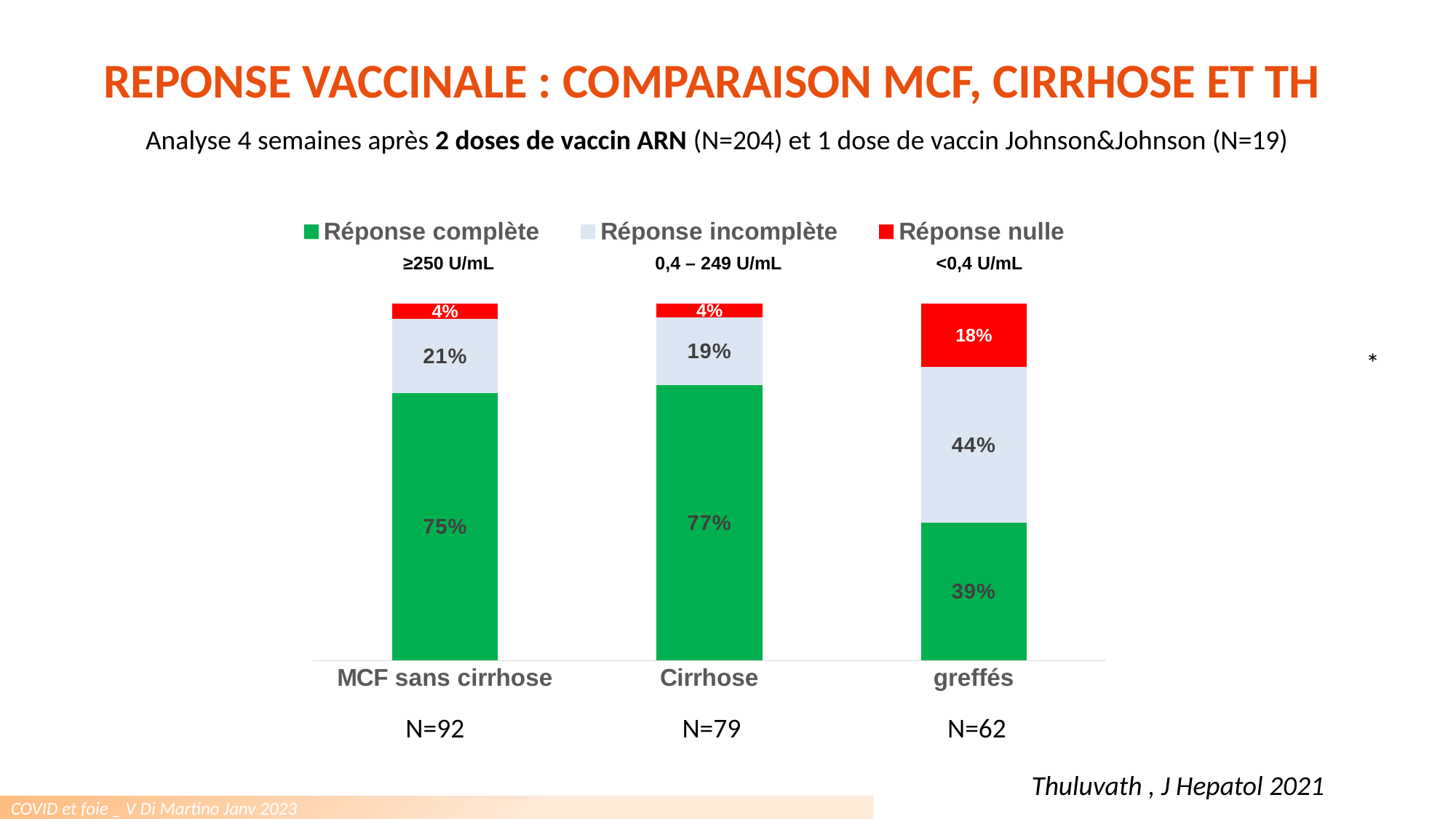
Which is larger, the Réponse incomplète value for MCF sans cirrhose or for Cirrhose? MCF sans cirrhose Which category has the highest Réponse nulle value? greffés How many series does the legend list? 3 Which category has the highest Réponse complète value? Cirrhose What is the value of Réponse nulle for Cirrhose? 4% What is the value of Réponse complète for greffés? 39% What is the value of Réponse incomplète for greffés? 44% What kind of chart is shown on the slide? Stacked bar chart How many categories are shown on the x axis? 3 What is the value of Réponse complète for MCF sans cirrhose? 75% What is the difference between the Réponse complète values for Cirrhose and greffés? 38% Which category has the lowest Réponse complète value? greffés